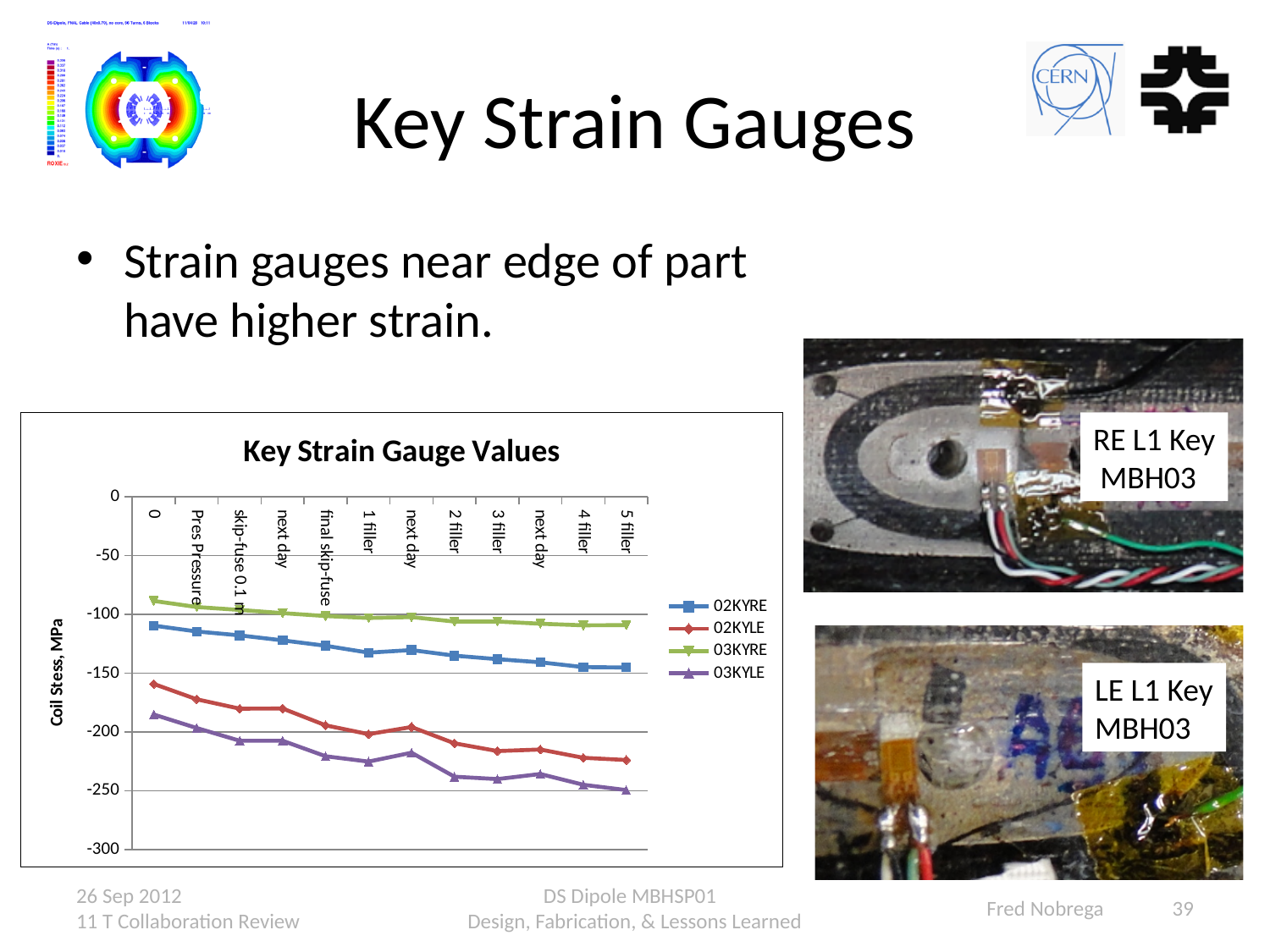
What kind of chart is the "Key Strain Gauge Values" chart? line chart In the "Key Strain Gauge Values" chart, is the value of 02KYLE at category "0" greater or less than -150? less In the "Key Strain Gauge Values" chart, which series has the highest (least negative) values? 03KYRE What is the title of the chart on the slide? Key Strain Gauge Values In the "Key Strain Gauge Values" chart, do the values of the 03KYLE series generally rise or fall along the x axis? fall In the "Key Strain Gauge Values" chart, which series has the lowest (most negative) values? 03KYLE In the "Key Strain Gauge Values" chart, at category "0", which is larger: the value of 02KYRE or the value of 02KYLE? 02KYRE In the "Key Strain Gauge Values" chart, is the value of 03KYRE at category "0" greater or less than -100? greater How many categories are shown on the x axis of the "Key Strain Gauge Values" chart? 12 In the "Key Strain Gauge Values" chart, is the value of 03KYLE at "5 filler" greater or less than -200? less What is the y-axis label of the "Key Strain Gauge Values" chart? Coil Stess, MPa How many series does the legend of the "Key Strain Gauge Values" chart list? 4